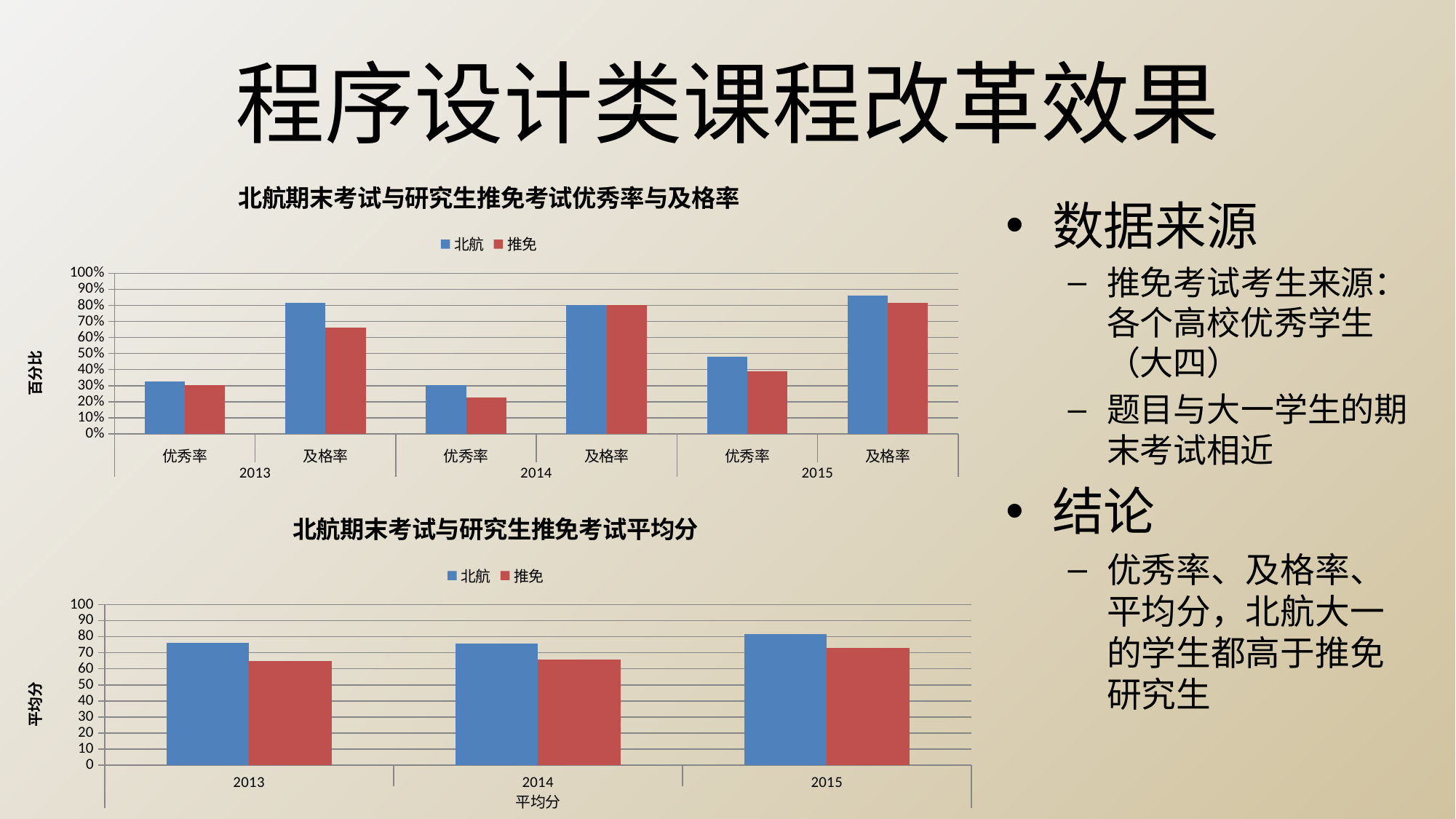
In the top chart (优秀率与及格率), how many series does the legend list? 2 In the top chart (优秀率与及格率), which category has the lowest 推免 bar? 2014 优秀率 What kind of chart is the top chart titled 北航期末考试与研究生推免考试优秀率与及格率? bar chart In the top chart (优秀率与及格率), is the 推免 value for 2014 优秀率 greater or less than 30%? less In the top chart (优秀率与及格率), which category has the highest 北航 bar? 2015 及格率 What is the vertical axis title of the bottom chart (平均分)? 平均分 In the bottom chart (平均分), is the 推免 value for 2013 greater or less than 70? less In the bottom chart (平均分), which series has the larger value for 2015, 北航 or 推免? 北航 In the top chart (优秀率与及格率), is the 北航 value for 2013 及格率 greater or less than 70%? greater In the top chart (优秀率与及格率), which series has the larger value for 2013 及格率, 北航 or 推免? 北航 In the bottom chart (平均分), does the 推免 series rise or fall from 2013 to 2015? rise In the bottom chart (平均分), how many year categories are shown on the x axis? 3